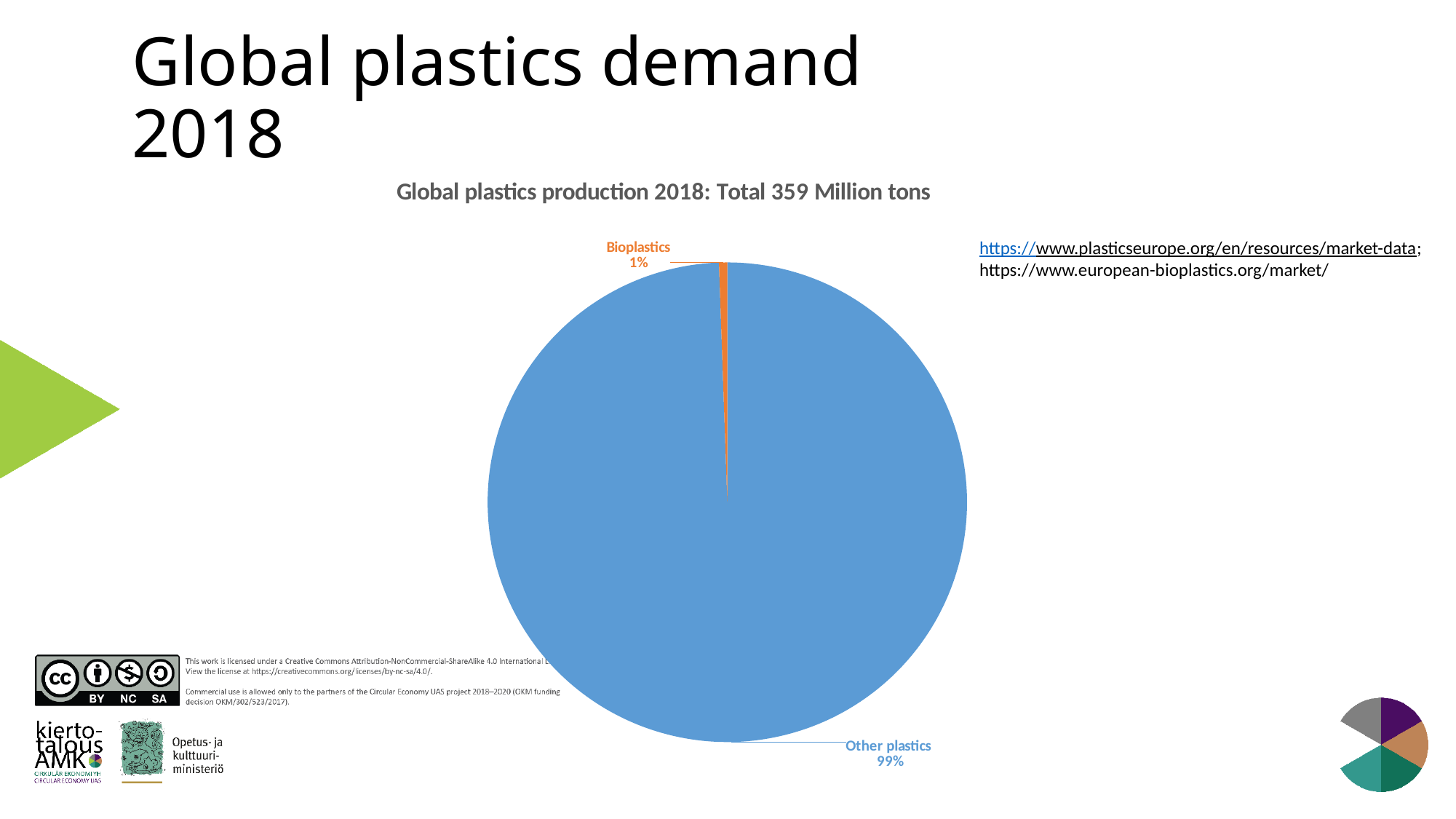
What total production figure is stated in the chart title? 359 Million tons What is the title of the chart? Global plastics production 2018: Total 359 Million tons What share of the pie does Other plastics represent? 99% How many slices does the pie chart have? 2 What share of the pie does Bioplastics represent? 1% What kind of chart is shown on the slide? Pie chart What is the difference in percentage points between the Other plastics share and the Bioplastics share? 98 percentage points Which slice of the pie is the largest? Other plastics Which is larger, the share for Bioplastics or the share for Other plastics? Other plastics Which slice of the pie is the smallest? Bioplastics What colour is the Bioplastics slice? Orange